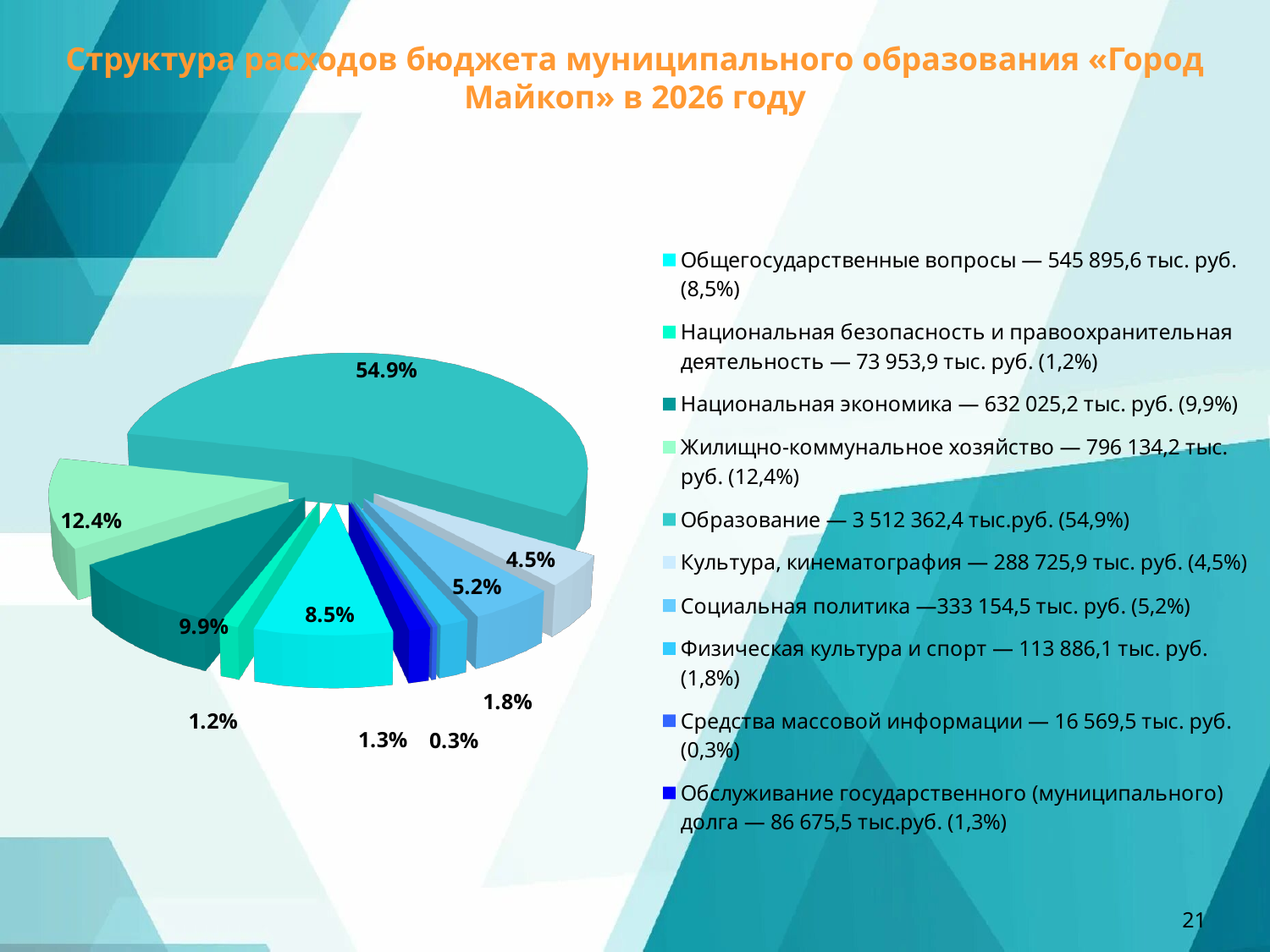
What share of the pie does Социальная политика have? 5.2% By how many percentage points does the share of Образование exceed the share of Жилищно-коммунальное хозяйство? 42.5 By how many percentage points does the share of Социальная политика exceed the share of Культура, кинематография? 0.7 Which has a larger share: Национальная экономика or Общегосударственные вопросы? Национальная экономика What kind of chart is shown on the slide? Pie chart According to the legend, what is the amount for Национальная экономика? 632 025,2 тыс. руб. What is the title of the slide? Структура расходов бюджета муниципального образования «Город Майкоп» в 2026 году Which category has the largest share of the pie? Образование Which category has the smallest share of the pie? Средства массовой информации How many categories (slices) does the pie chart have? 10 What share of the pie does Жилищно-коммунальное хозяйство have? 12.4% According to the legend, what is the amount for Культура, кинематография? 288 725,9 тыс. руб.